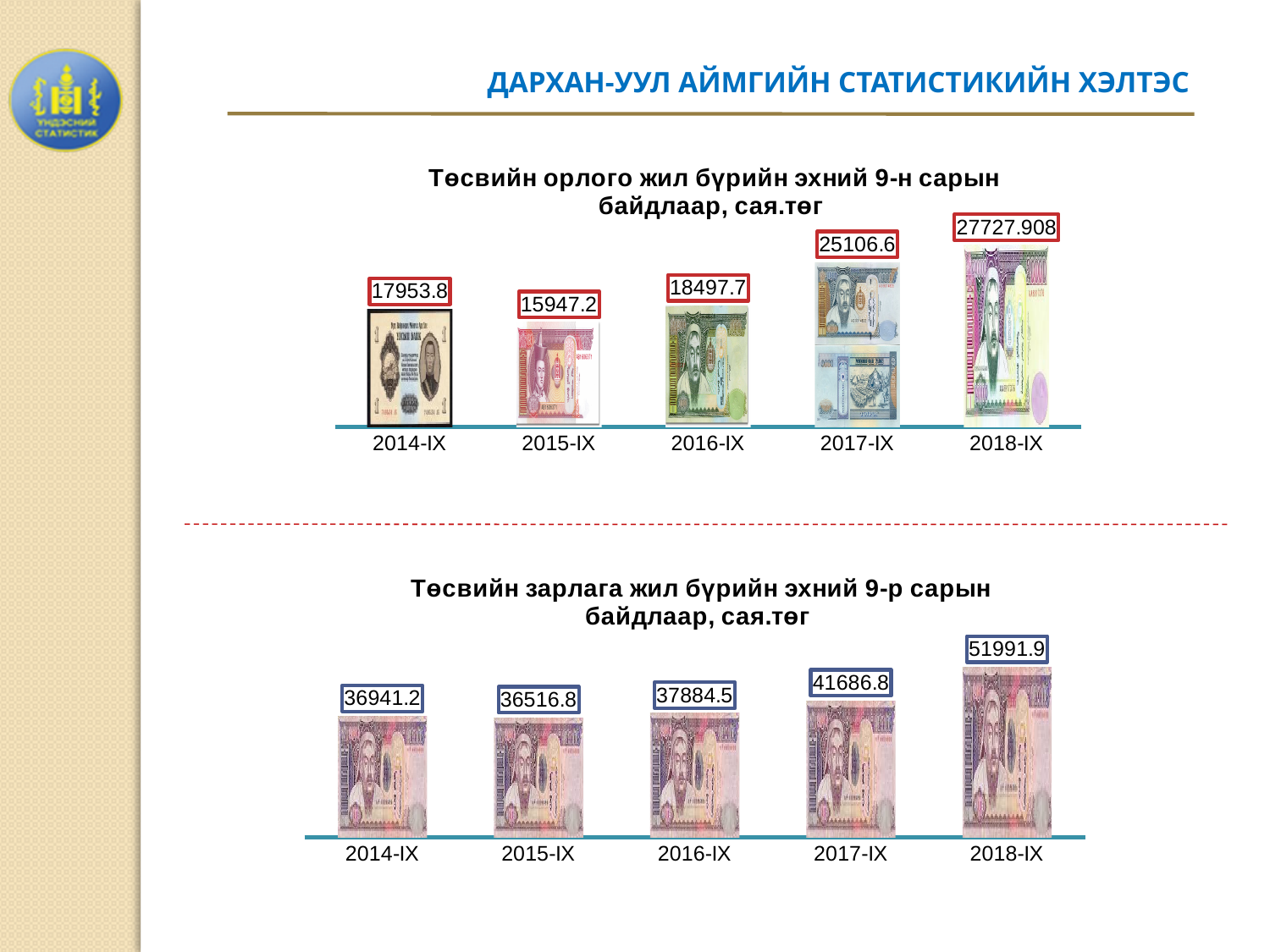
In the top chart (Төсвийн орлого), which year has the highest value? 2018-IX In the top chart (Төсвийн орлого), what is the value for 2017-IX? 25106.6 In the bottom chart (Төсвийн зарлага), which year has the lowest value? 2015-IX In the bottom chart (Төсвийн зарлага), what is the value for 2016-IX? 37884.5 In the bottom chart (Төсвийн зарлага), which is larger, the value for 2014-IX or 2015-IX? 2014-IX In the bottom chart (Төсвийн зарлага), what is the value for 2018-IX? 51991.9 In the top chart (Төсвийн орлого), what is the value for 2015-IX? 15947.2 What kind of chart is the bottom chart (Төсвийн зарлага)? Bar chart In the top chart (Төсвийн орлого), what is the difference between the 2017-IX and 2016-IX values? 6608.9 In the bottom chart (Төсвийн зарлага), what is the difference between the 2018-IX and 2017-IX values? 10305.1 In the top chart (Төсвийн орлого), how many years are shown on the x axis? 5 In the top chart (Төсвийн орлого), which year has the lowest value? 2015-IX